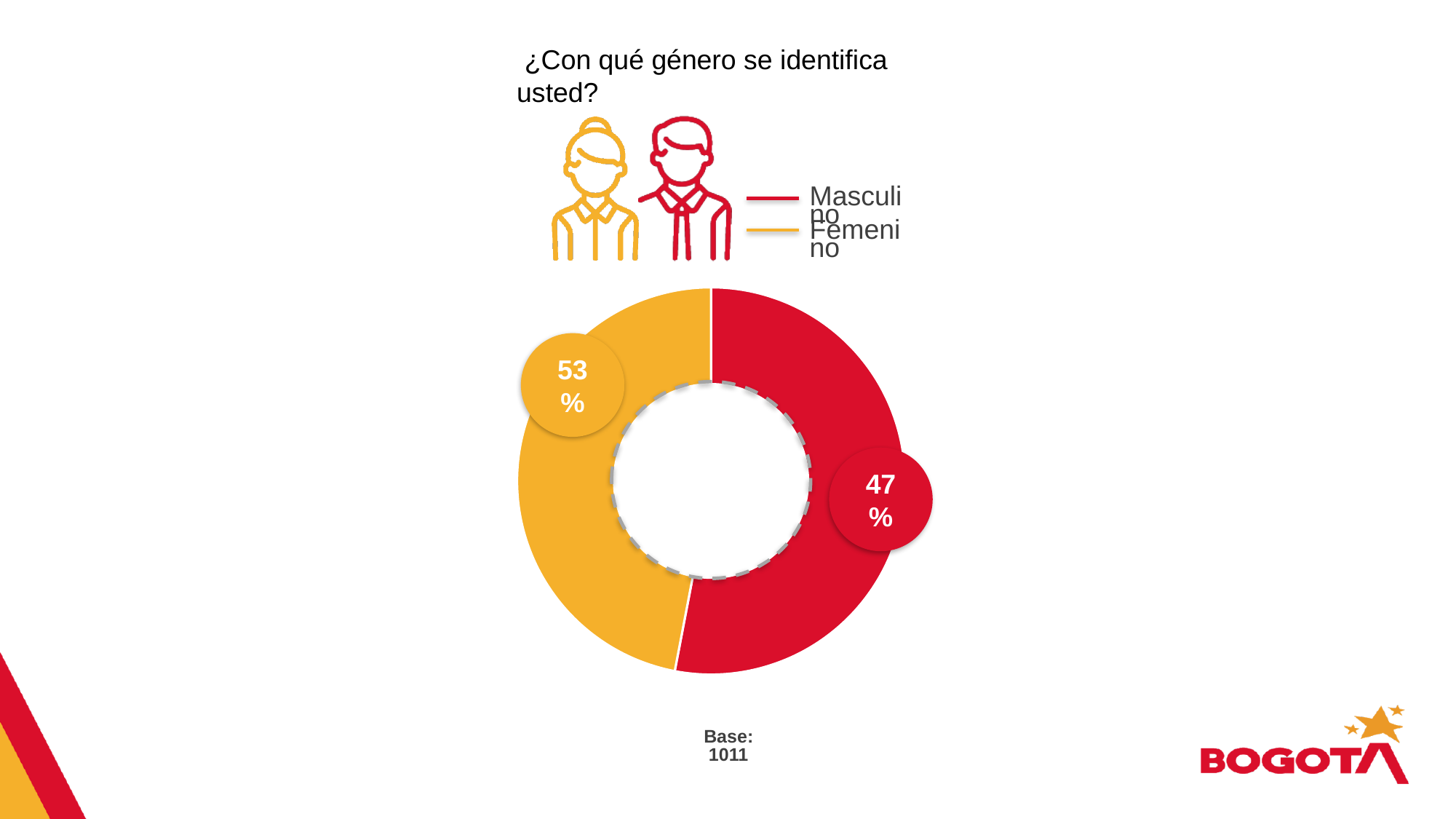
What percentage of respondents identified as Femenino? 53% What kind of chart is shown on the slide? pie chart (doughnut) What is the base (number of respondents) shown below the chart? 1011 What percentage of respondents identified as Masculino? 47% Is the share for Femenino larger or smaller than the share for Masculino? larger Which gender category has the smaller share? Masculino What is the difference in percentage points between Femenino and Masculino? 6 How many categories does the chart show? 2 Which colour represents Masculino in the chart? red Which gender category has the larger share? Femenino How many entries does the legend list? 2